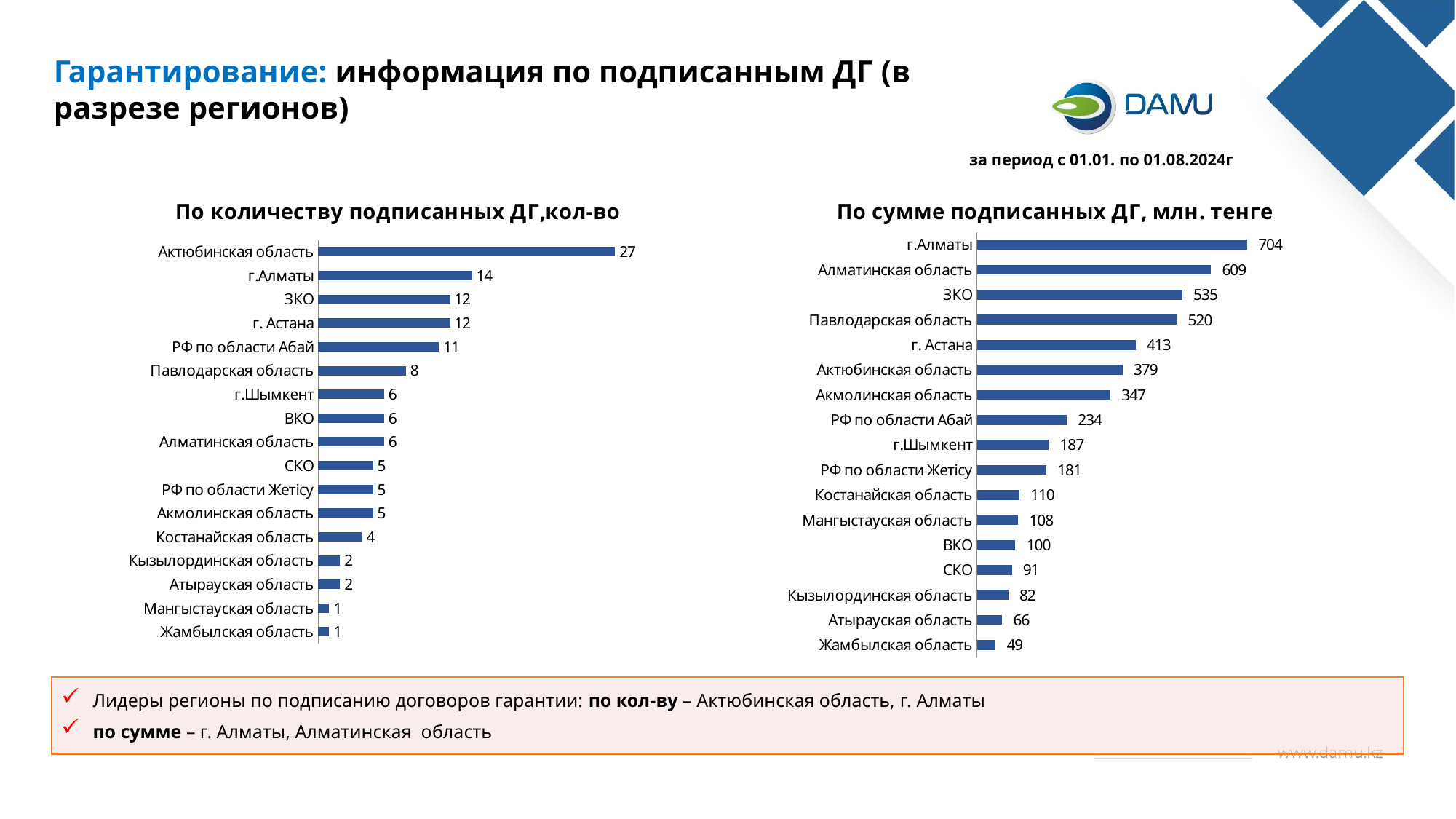
In the chart 'По сумме подписанных ДГ, млн. тенге', what is the value for РФ по области Жетісу? 181 In the chart 'По количеству подписанных ДГ,кол-во', how many regions are shown? 17 In the chart 'По количеству подписанных ДГ,кол-во', what is the difference between г.Алматы and Павлодарская область? 6 In the chart 'По сумме подписанных ДГ, млн. тенге', which region has the highest value? г.Алматы In the chart 'По сумме подписанных ДГ, млн. тенге', which region has the lowest value? Жамбылская область In the chart 'По сумме подписанных ДГ, млн. тенге', how many regions are shown? 17 In the chart 'По количеству подписанных ДГ,кол-во', what is the value for Актюбинская область? 27 In the chart 'По сумме подписанных ДГ, млн. тенге', what is the value for Павлодарская область? 520 In the chart 'По сумме подписанных ДГ, млн. тенге', which is larger: ВКО or СКО? ВКО In the chart 'По сумме подписанных ДГ, млн. тенге', what is the difference between г.Алматы and Алматинская область? 95 What type of chart is 'По количеству подписанных ДГ,кол-во'? Bar chart In the chart 'По количеству подписанных ДГ,кол-во', which region has the highest value? Актюбинская область